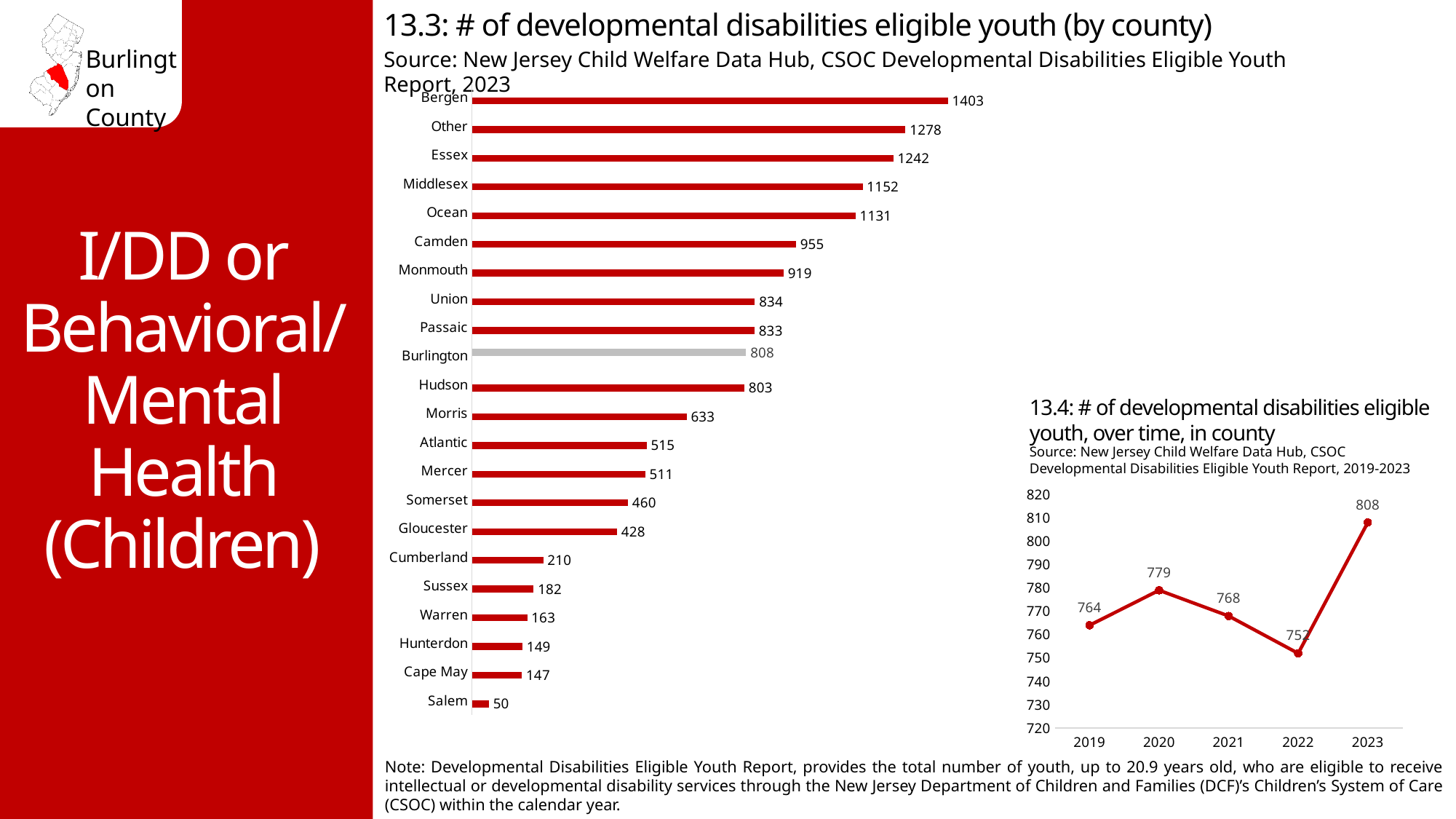
In chart 13.3 (by county), what is the difference between the values for Bergen and Essex? 161 In chart 13.3 (# of developmental disabilities eligible youth by county), what is the value for Burlington? 808 In chart 13.4 (over time, in county), what is the value for 2023? 808 In chart 13.4 (over time, in county), what is the value for 2020? 779 In chart 13.3 (by county), which county has the highest number of developmental disabilities eligible youth? Bergen In chart 13.4 (over time, in county), is the value for 2022 greater or less than 760? less In chart 13.3 (by county), which has a larger value, Morris or Atlantic? Morris In chart 13.3 (by county), what is the value for Camden? 955 In chart 13.4 (over time, in county), what is the difference between the values for 2023 and 2019? 44 In chart 13.3 (by county), how many categories (bars) are shown? 22 What kind of chart is chart 13.3 (# of developmental disabilities eligible youth by county)? Bar chart In chart 13.3 (by county), which county has the lowest number of developmental disabilities eligible youth? Salem